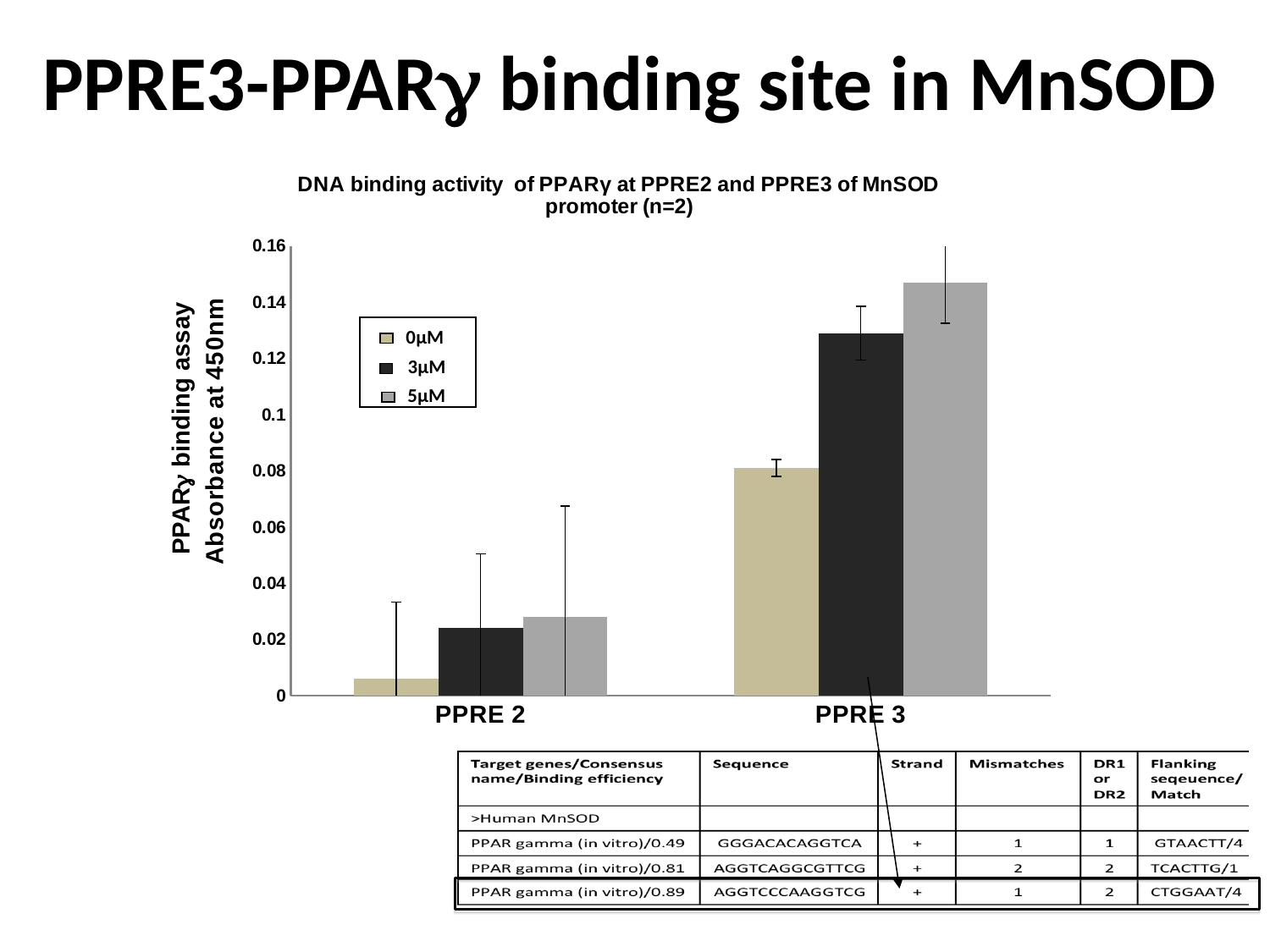
Is the value for 3µM at PPRE 3 greater or less than 0.12? greater Within the PPRE 3 category, do the bars rise or fall as the concentration increases from 0µM to 5µM? rise Is the value for 0µM at PPRE 2 greater or less than 0.02? less What is the title of the chart? DNA binding activity of PPARγ at PPRE2 and PPRE3 of MnSOD promoter (n=2) How many categories are shown on the x axis of the chart? 2 Which is larger: the 0µM bar at PPRE 3 or the 5µM bar at PPRE 2? 0µM at PPRE 3 Which category and series has the lowest bar in the chart? 0µM at PPRE 2 Which category and series has the highest bar in the chart? 5µM at PPRE 3 How many series does the chart legend list? 3 Is the value for 5µM at PPRE 3 greater or less than 0.1? greater What kind of chart is shown on the slide? bar chart